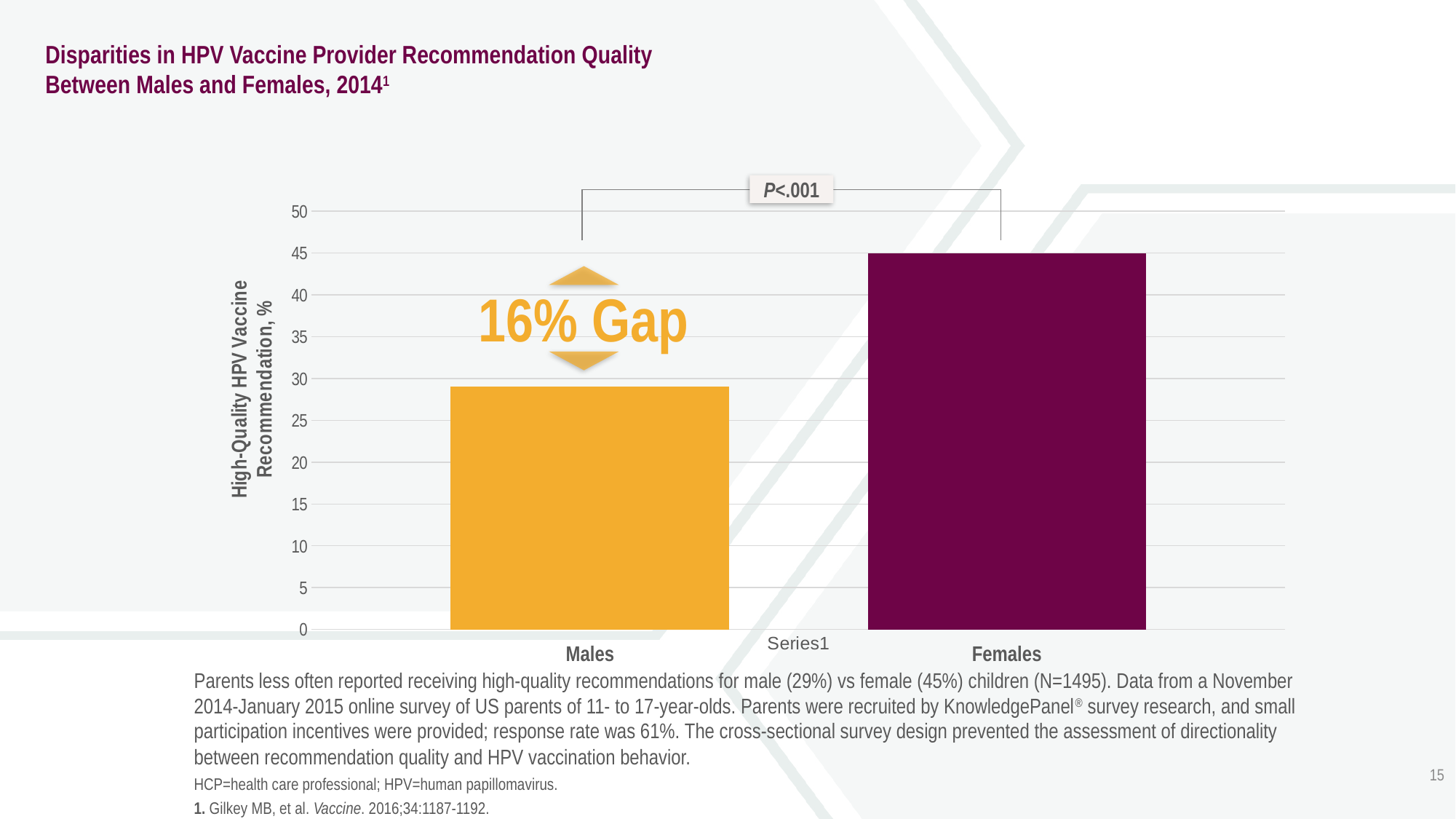
What P value is shown above the bars in the chart? P<.001 What is the label of the y-axis? High-Quality HPV Vaccine Recommendation, % Is the value for Males greater or less than 30? less How many categories are plotted in the chart? 2 Which category has the higher value, Males or Females? Females What is the value for Males in the chart? 29% What type of chart is shown on the slide? bar chart Which category has the highest value in the chart? Females Which category has the lowest value in the chart? Males What is the value for Females in the chart? 45% What is the gap between the Females and Males values shown on the chart? 16% Is the value for Females greater or less than 40? greater